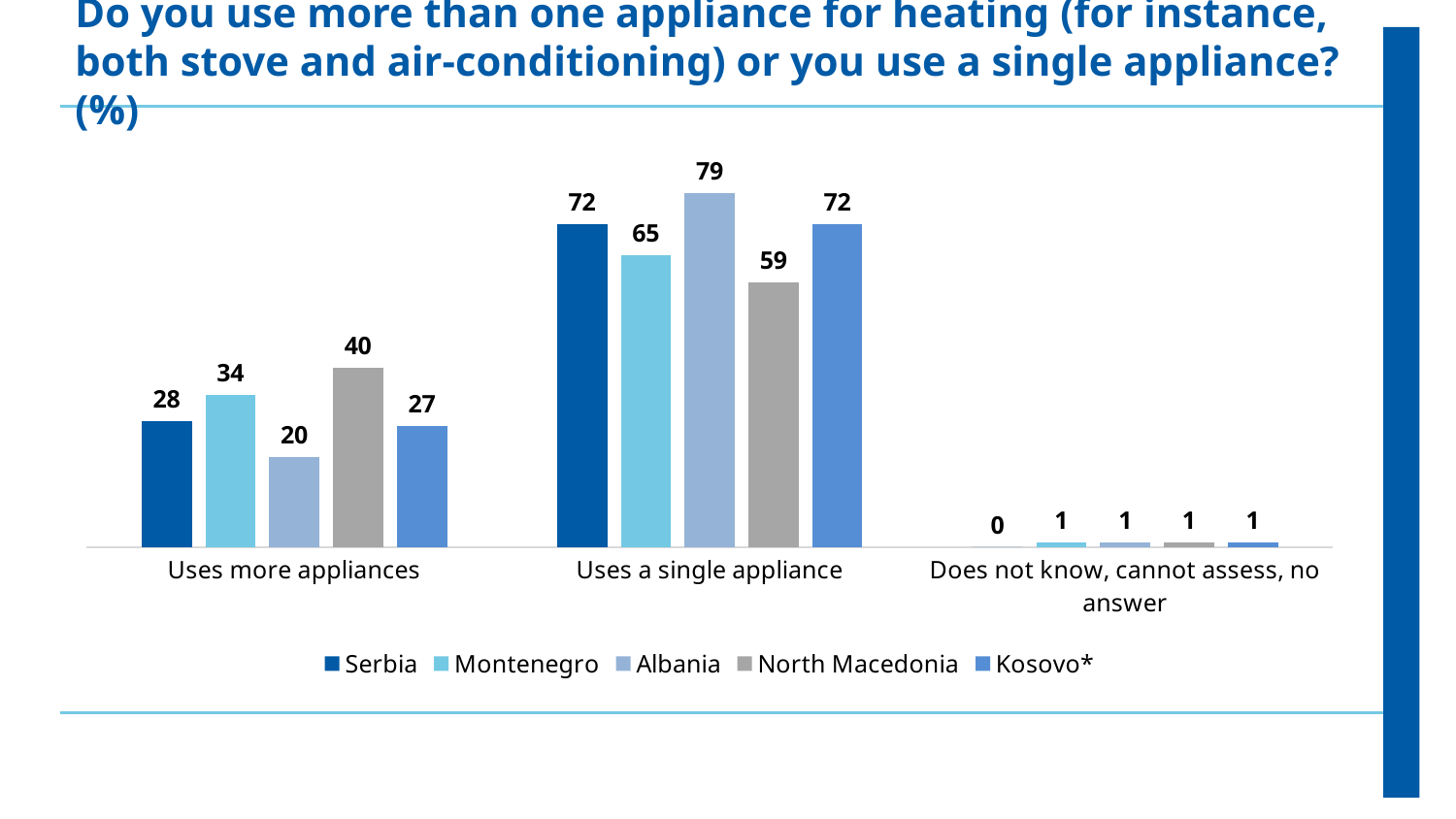
Which country has the lowest value in the 'Uses more appliances' category? Albania What is the value for North Macedonia in the 'Uses more appliances' category? 40 Which is larger in the 'Uses more appliances' category: Montenegro or Kosovo*? Montenegro What is the difference between Serbia's values for 'Uses a single appliance' and 'Uses more appliances'? 44 Which legend entry is marked with an asterisk? Kosovo* What kind of chart is shown on the slide? Bar chart What is the value for Serbia in the 'Does not know, cannot assess, no answer' category? 0 What is the value for Albania in the 'Uses a single appliance' category? 79 Which country has the highest value in the 'Uses a single appliance' category? Albania How many series does the legend list? 5 What is the difference between Albania and North Macedonia in the 'Uses a single appliance' category? 20 How many response categories are shown on the x axis? 3